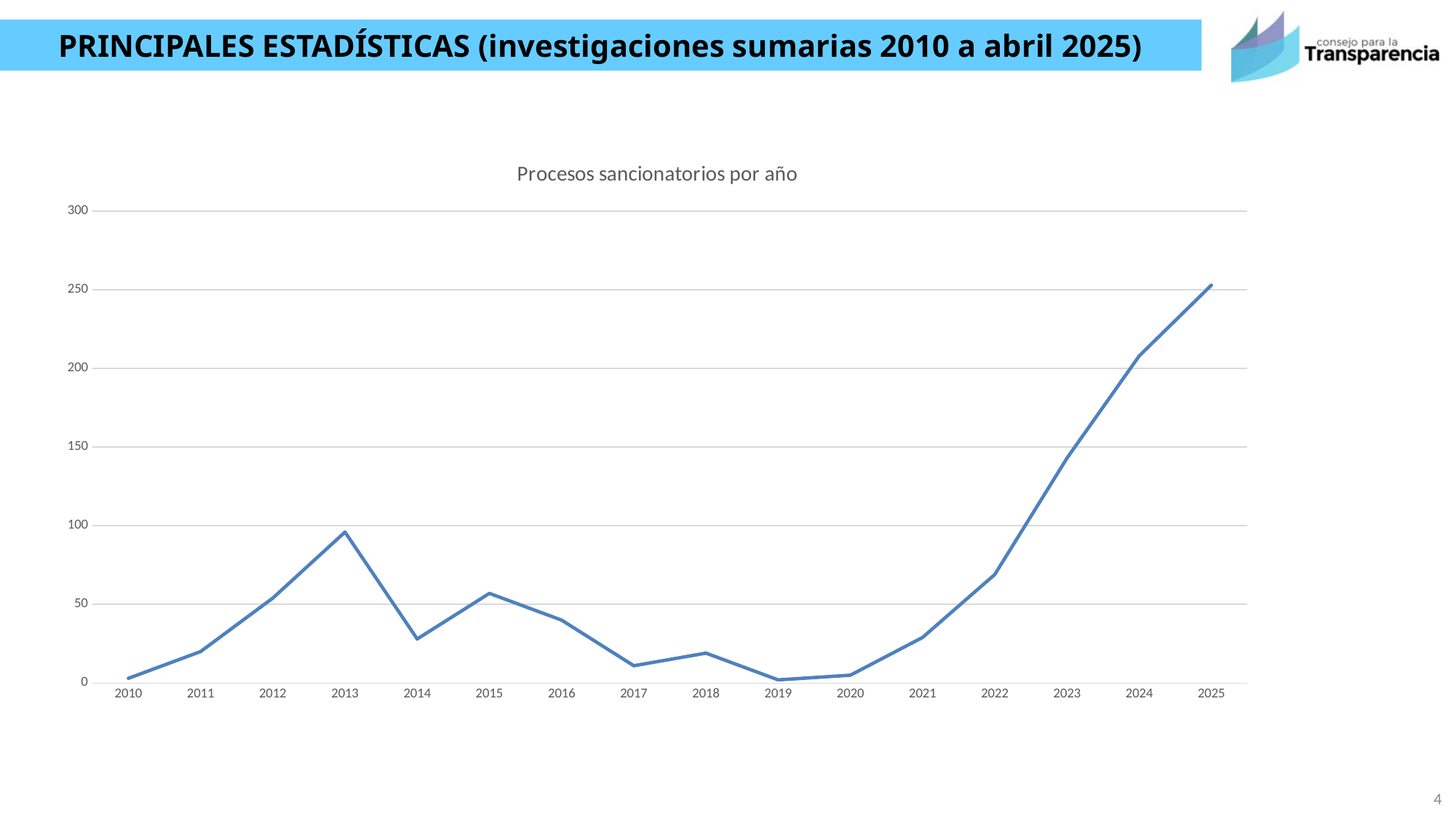
Is the value for 2023 greater or less than 100? greater Which year has the highest value in the chart? 2025 What kind of chart is shown on the slide? line chart Is the value for 2022 greater or less than 50? greater What is the title of the chart? Procesos sancionatorios por año Which year has the larger value, 2012 or 2014? 2012 Do the values rise or fall from 2020 to 2025? rise Is the value for 2013 greater or less than 50? greater How many years are plotted on the x axis of the chart? 16 Which year has the larger value, 2013 or 2015? 2013